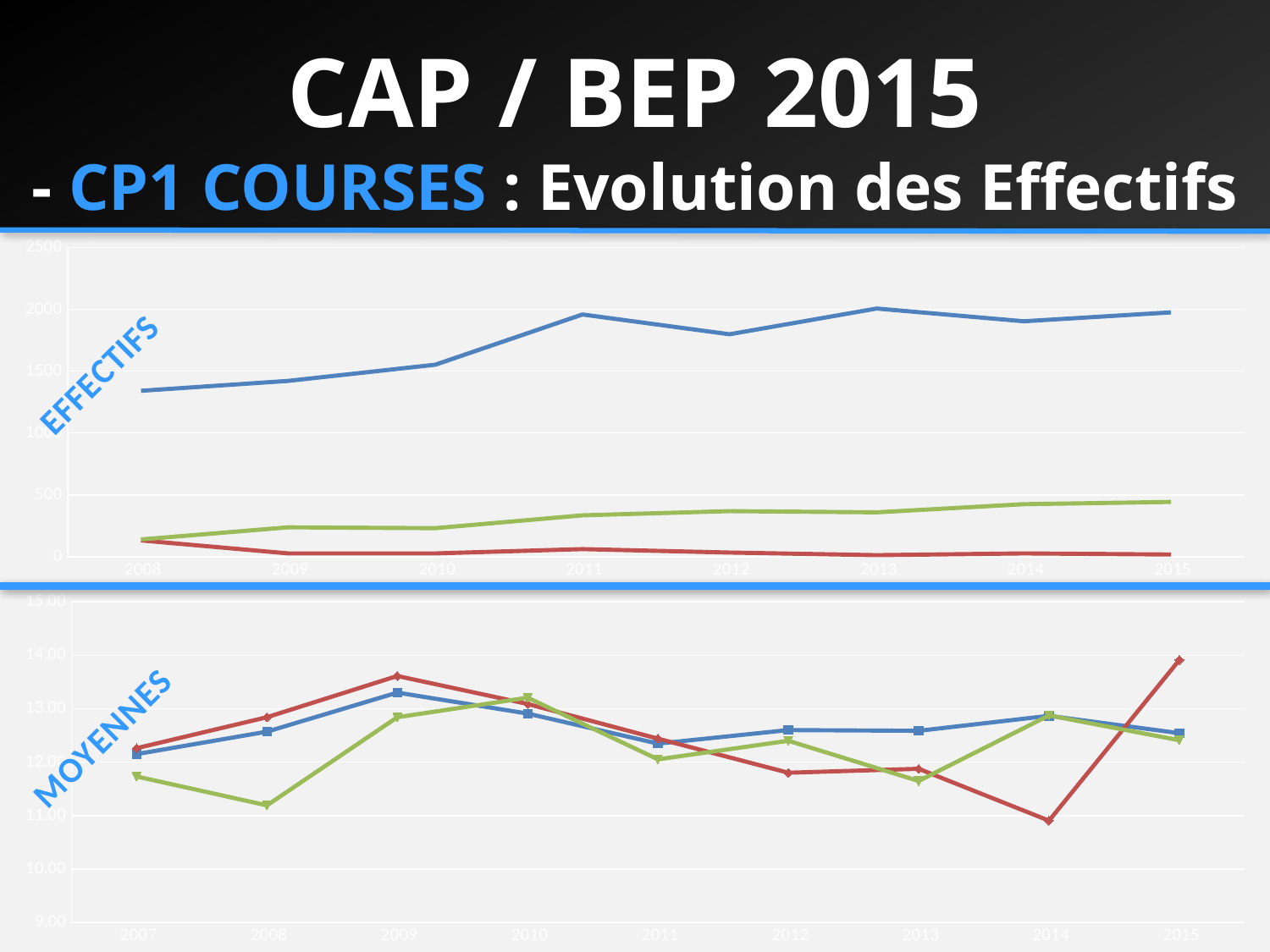
What type of chart is the top chart (EFFECTIFS)? line chart How many years are shown on the x axis of the top chart (EFFECTIFS)? 8 In the top chart (EFFECTIFS), does the red line overall rise or fall from 2008 to 2015? fall In the top chart (EFFECTIFS), does the blue line overall rise or fall from 2008 to 2015? rise In the bottom chart (MOYENNES), is the value of the green line in 2008 greater or less than 12.00? less How many years are shown on the x axis of the bottom chart (MOYENNES)? 9 In the top chart (EFFECTIFS), is the value of the green line in 2015 greater or less than 500? less In the top chart (EFFECTIFS), is the value of the blue line in 2008 greater or less than 1000? greater In the bottom chart (MOYENNES), in which year does the red line reach its lowest value? 2014 In the bottom chart (MOYENNES), in which year does the red line reach its highest value? 2015 In the top chart (EFFECTIFS), which line has the highest values across all years: blue, green or red? blue